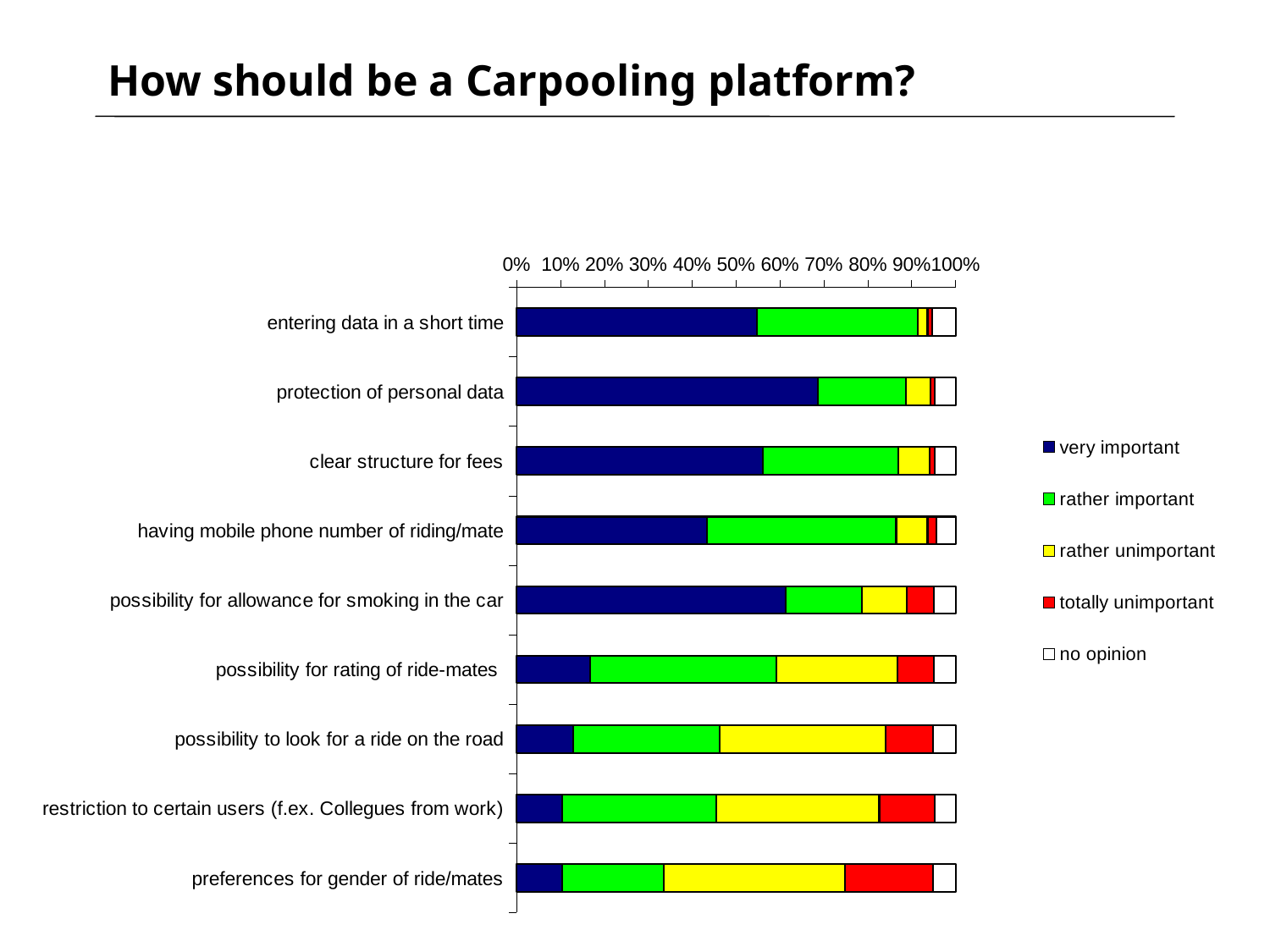
What kind of chart is shown on the slide? stacked bar chart Which category has the largest 'very important' share? protection of personal data Is the 'very important' share for 'protection of personal data' greater or less than 60%? greater What is the title of the slide containing the chart? How should be a Carpooling platform? Is the 'very important' share for 'entering data in a short time' greater or less than 50%? greater Is the 'totally unimportant' share for 'preferences for gender of ride/mates' greater or less than 10%? greater How many categories (platform features) are plotted on the chart? 9 Which category has the largest 'totally unimportant' share? preferences for gender of ride/mates Going from the top category to the bottom category, does the 'very important' share generally rise or fall? fall Which has the larger 'very important' share: 'clear structure for fees' or 'possibility to look for a ride on the road'? clear structure for fees How many series does the legend list? 5